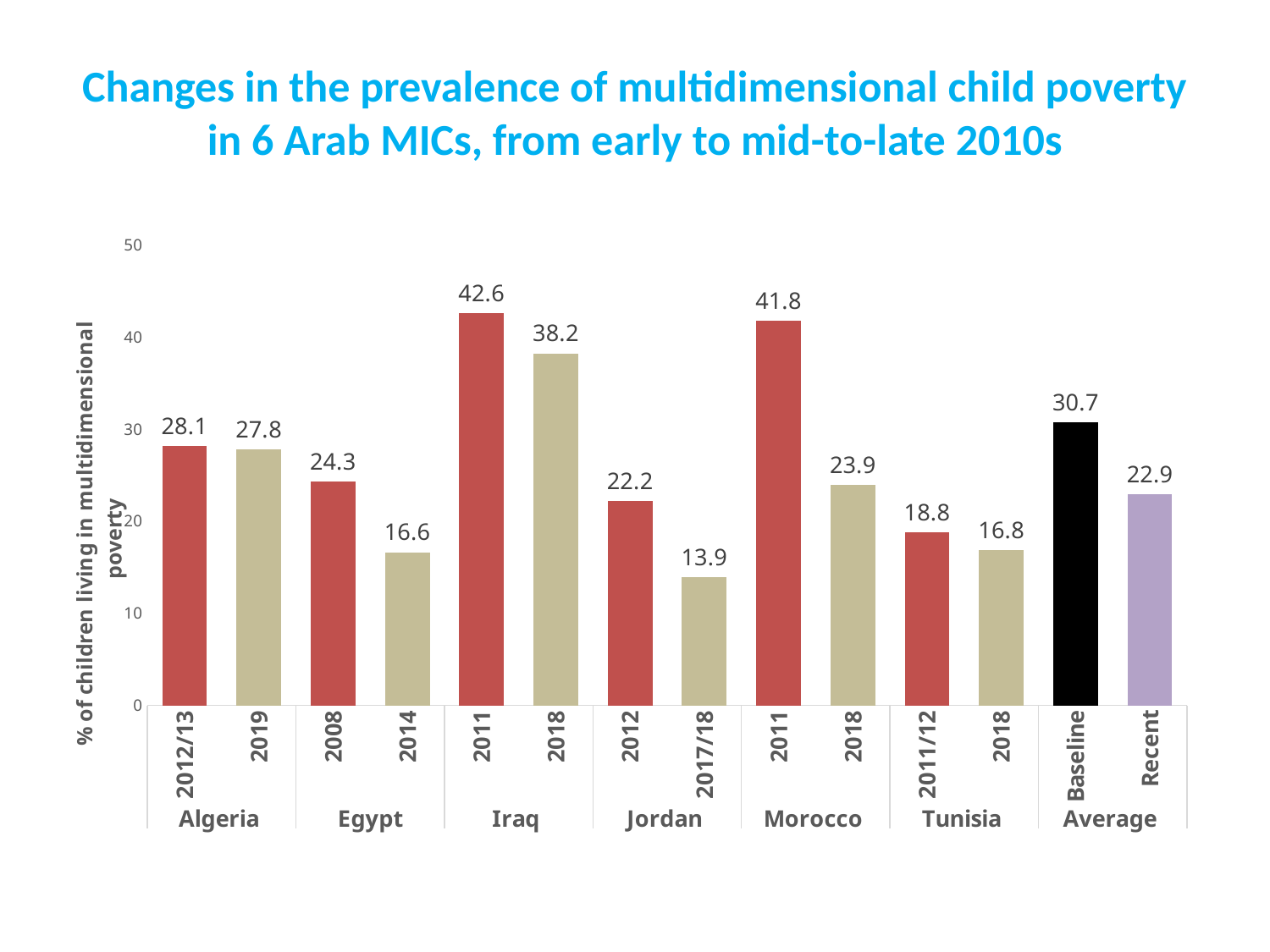
How many bars are plotted on the chart? 14 What is the Recent value for the Average group? 22.9 What is the title of the y axis? % of children living in multidimensional poverty What is the value for Egypt in 2014? 16.6 What is the value for Jordan in 2017/18? 13.9 Which bar has the lowest value on the chart? Jordan 2017/18 What is the difference between Morocco's 2011 and 2018 values? 17.9 Which is larger, Tunisia's 2011/12 value or Tunisia's 2018 value? Tunisia 2011/12 What is the value for Iraq in 2011? 42.6 Which bar has the highest value on the chart? Iraq 2011 What is the difference between the Average Baseline and Recent values? 7.8 What kind of chart is shown on the slide? Bar chart